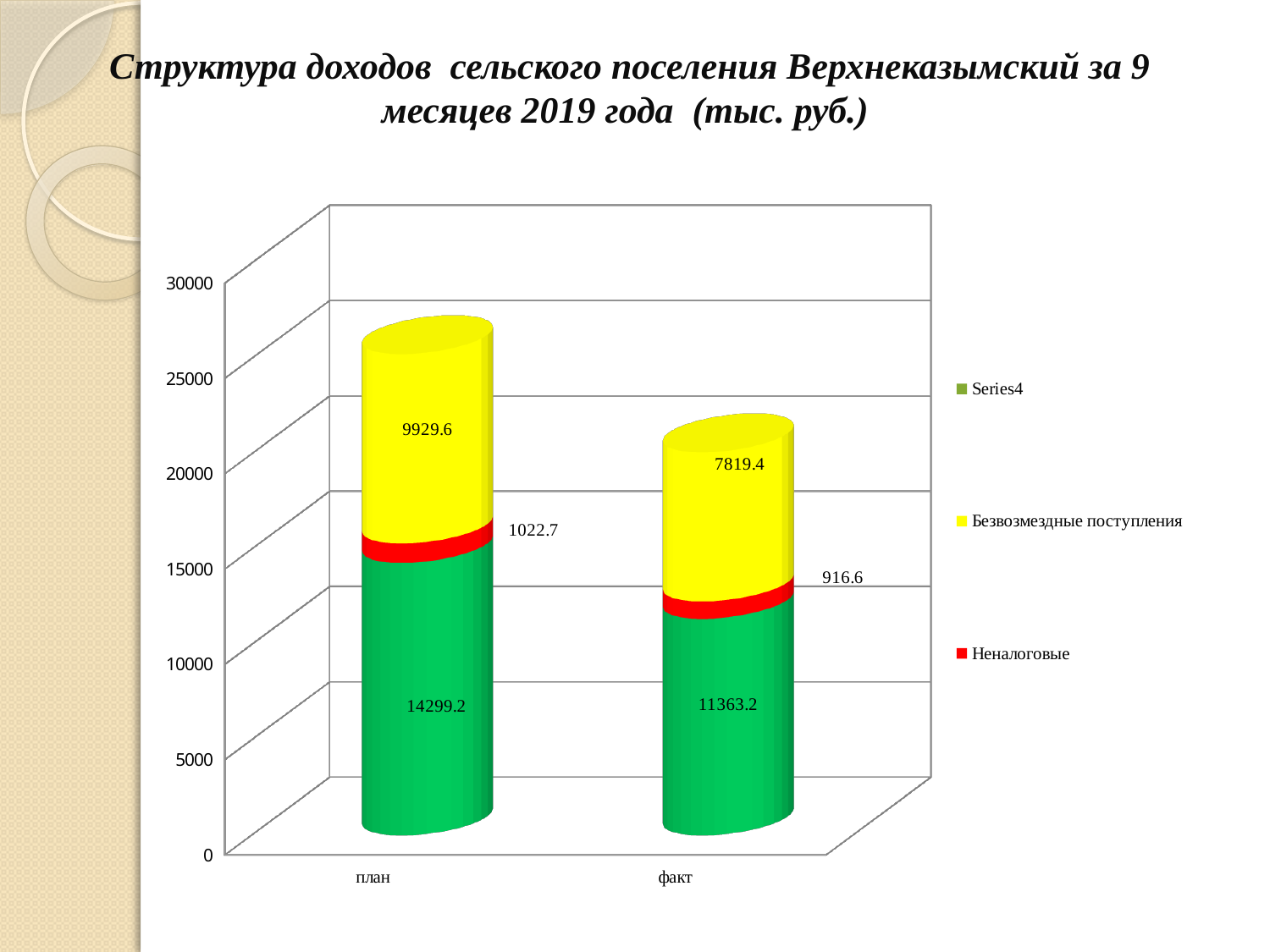
What is the difference between the Безвозмездные поступления values for план and факт? 2110.2 What is the value of Неналоговые for факт? 916.6 How many categories are shown on the x axis? 2 Which category has the larger Неналоговые value, план or факт? план What is the total of the stacked bar for план? 25251.5 What is the total of the stacked bar for факт? 20099.2 What kind of chart is shown on the slide? Stacked bar chart What is the value of Безвозмездные поступления for факт? 7819.4 What is the value of the green segment of the факт bar? 11363.2 What is the value of Неналоговые for план? 1022.7 What is the difference between the green segment values for план and факт? 2936 What is the value of Безвозмездные поступления for план? 9929.6